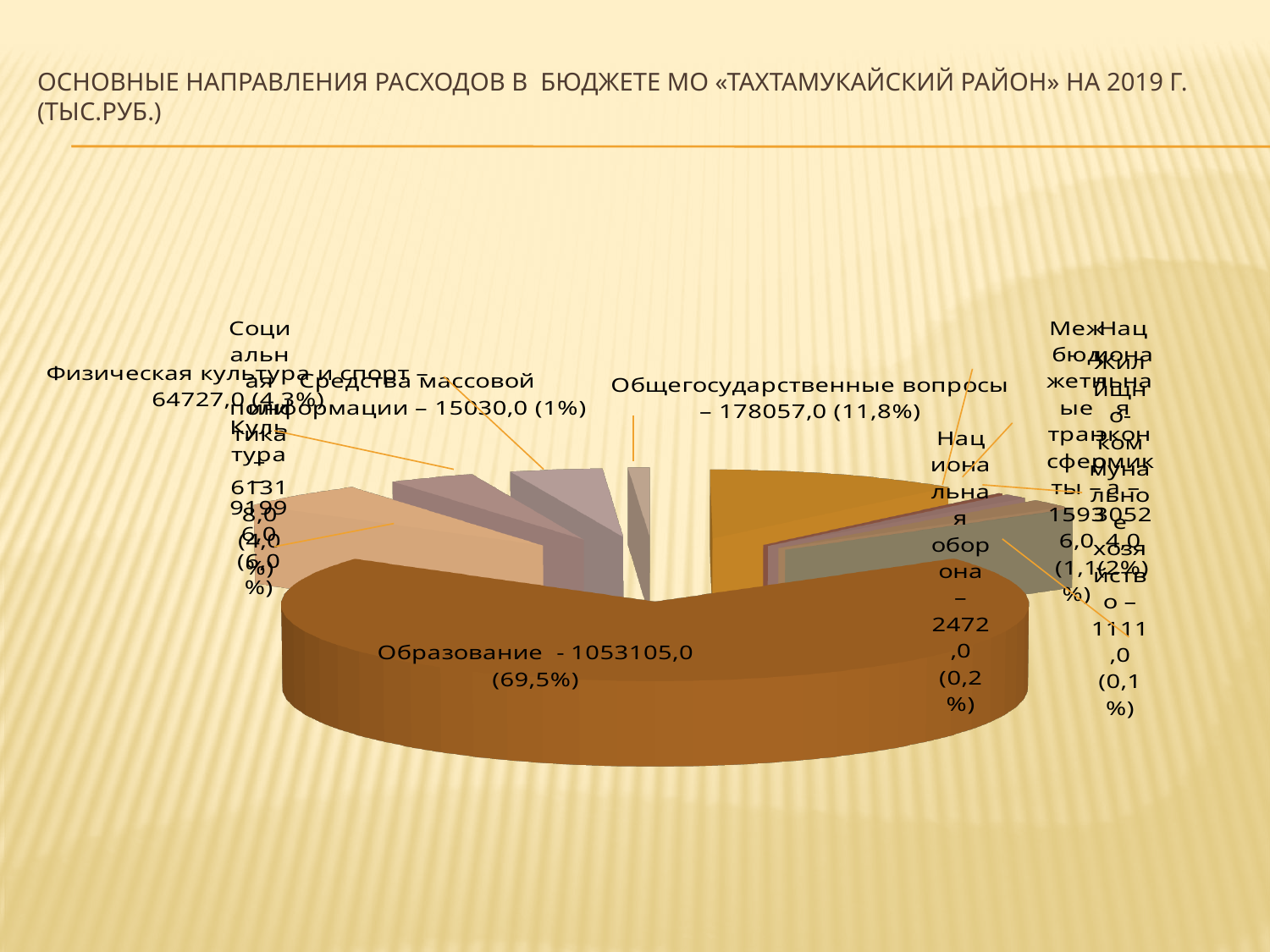
What year does the chart title say the budget is for? 2019 What share of the pie does Образование take? 69,5% What is the difference between the values for Общегосударственные вопросы and Средства массовой информации? 163027,0 What is the value for Национальная оборона? 2472,0 What kind of chart is shown on the slide? pie chart What is the value for Средства массовой информации? 15030,0 Which is larger, the value for Физическая культура и спорт or the value for Средства массовой информации? Физическая культура и спорт What is the value for Образование? 1053105,0 What share of the pie does Общегосударственные вопросы take? 11,8% What is the value for Физическая культура и спорт? 64727,0 What is the value for Общегосударственные вопросы? 178057,0 Which expenditure category has the largest share of the budget? Образование